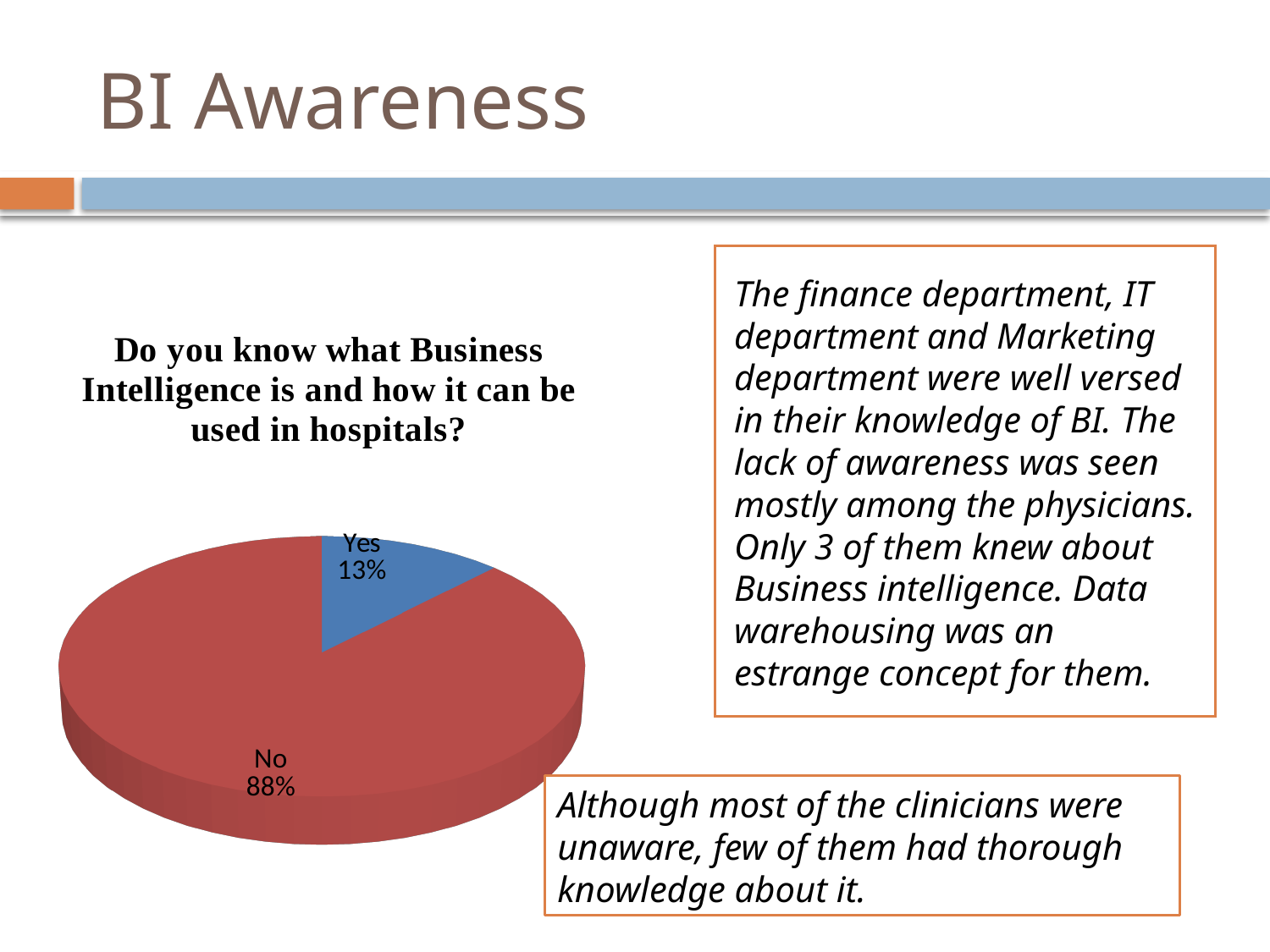
What percentage of respondents answered "No"? 88% What kind of chart is shown on the slide? pie chart What is the title of the pie chart? Do you know what Business Intelligence is and how it can be used in hospitals? What is the difference in percentage points between the "No" and "Yes" slices? 75 How many slices does the pie chart have? 2 Which is larger, the share for "Yes" or the share for "No"? No What percentage of respondents answered "Yes"? 13% What colour is the "Yes" slice of the pie chart? blue Which response has the largest share of the pie? No Which response has the smallest share of the pie? Yes